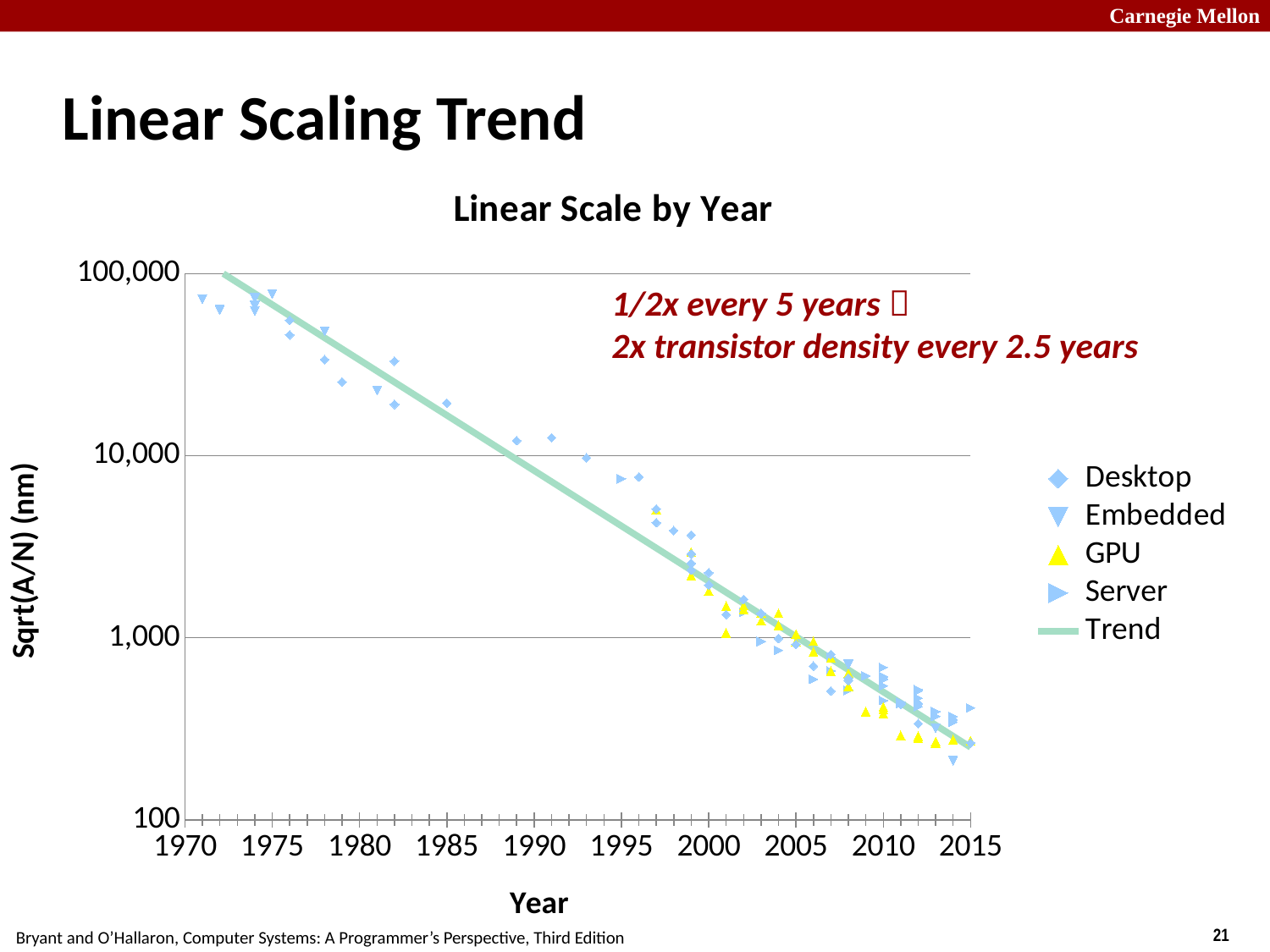
Which legend series is drawn as a line rather than as markers? Trend Are the Embedded values plotted around 1975 greater or less than 10,000? greater What is the label of the y axis? Sqrt(A/N) (nm) Are the Desktop values plotted around 1990 greater or less than 1,000? greater What is the lowest value shown on the y axis? 100 Are the Server values plotted around 2010 greater or less than 1,000? less Do the plotted values rise or fall as the year increases along the x axis? fall Which is larger: the Desktop value plotted around 1982 or the Desktop value plotted around 2000? the Desktop value around 1982 What kind of chart is shown on the slide? scatter chart How many entries does the chart's legend list? 5